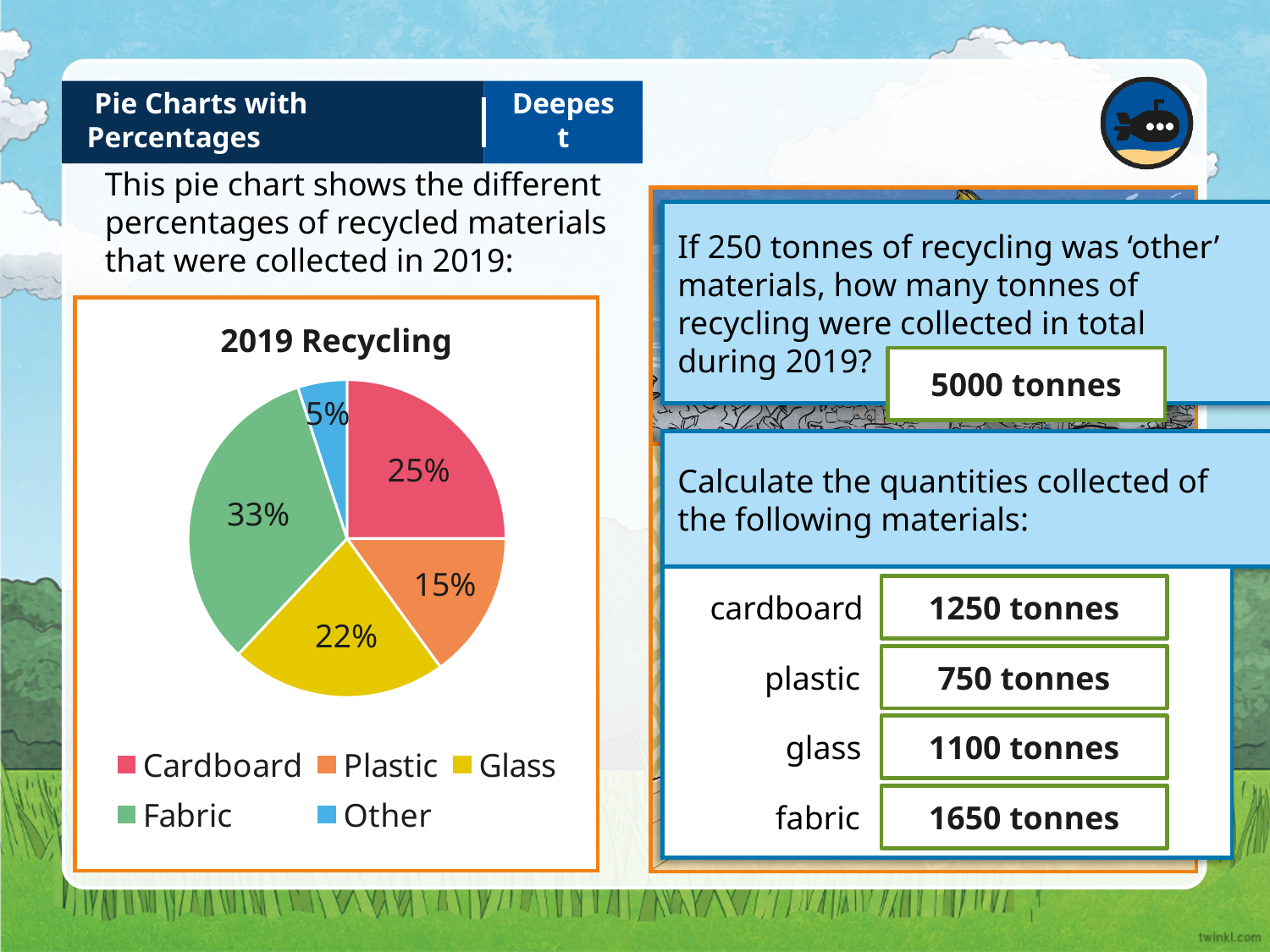
What percentage of the 2019 Recycling pie chart is Other? 5% Which material has the smallest slice in the 2019 Recycling pie chart? Other Which colour represents Plastic in the 2019 Recycling pie chart? Orange What type of chart is used to show the 2019 Recycling data? Pie chart What percentage of the 2019 Recycling pie chart is Fabric? 33% Which slice is larger in the 2019 Recycling pie chart, Cardboard or Glass? Cardboard What percentage of the 2019 Recycling pie chart is Glass? 22% What is the difference in percentage points between Fabric and Plastic in the 2019 Recycling pie chart? 18 Which material has the largest slice in the 2019 Recycling pie chart? Fabric What is the title of the pie chart on the slide? 2019 Recycling How many slices does the 2019 Recycling pie chart have? 5 What percentage of the 2019 Recycling pie chart is Cardboard? 25%